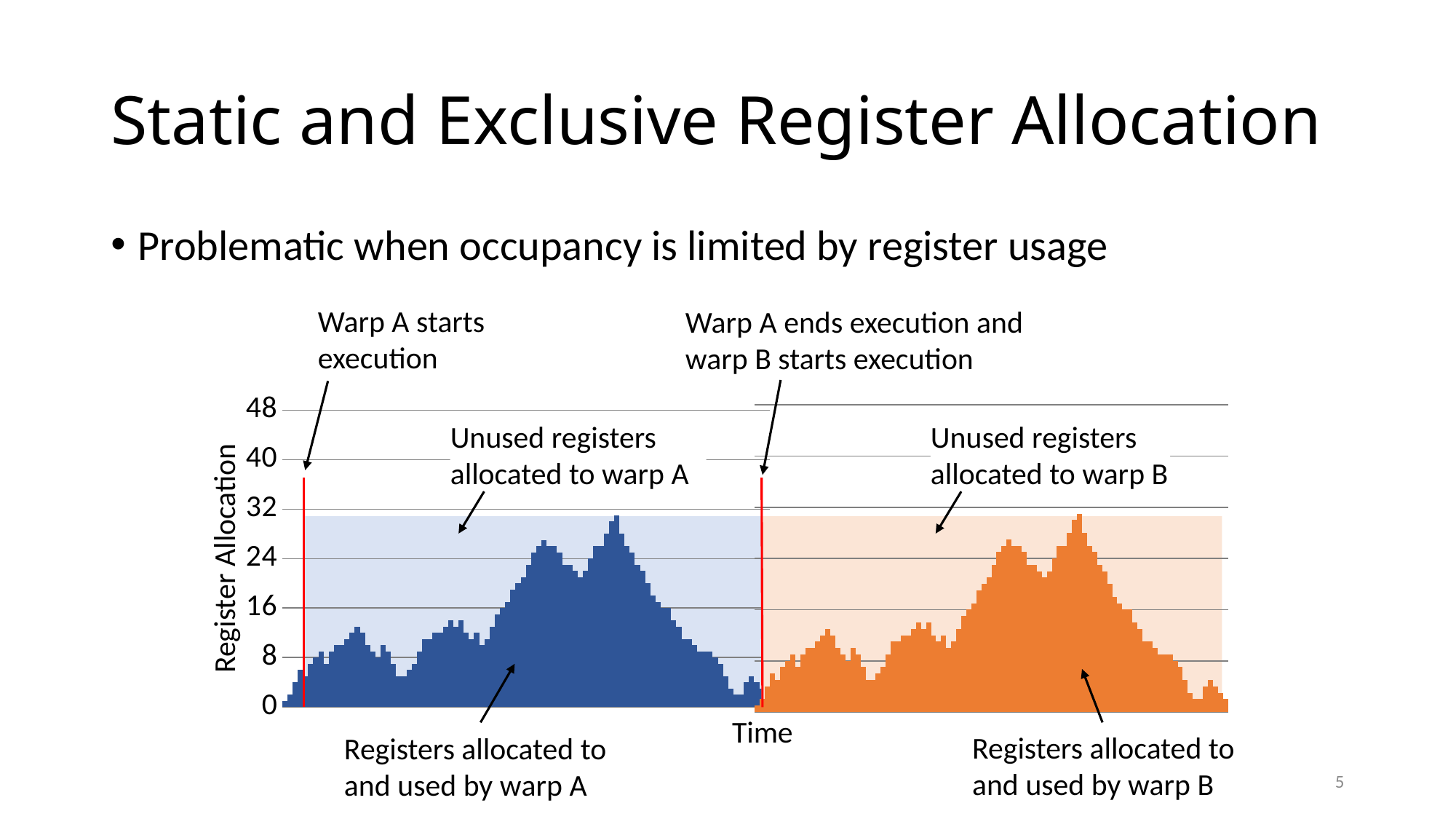
What is the highest value shown on the vertical axis of the chart? 48 Is the number of registers allocated to warp A (the top of the light shaded region) greater or less than 24? greater What event does the second red vertical line in the chart mark? Warp A ends execution and warp B starts execution Is the number of registers used by warp A at the very start of its execution greater or less than 8? less Which warp's register usage is shown in orange? Warp B Is the number of registers used by warp B at the very end of its execution greater or less than 8? less